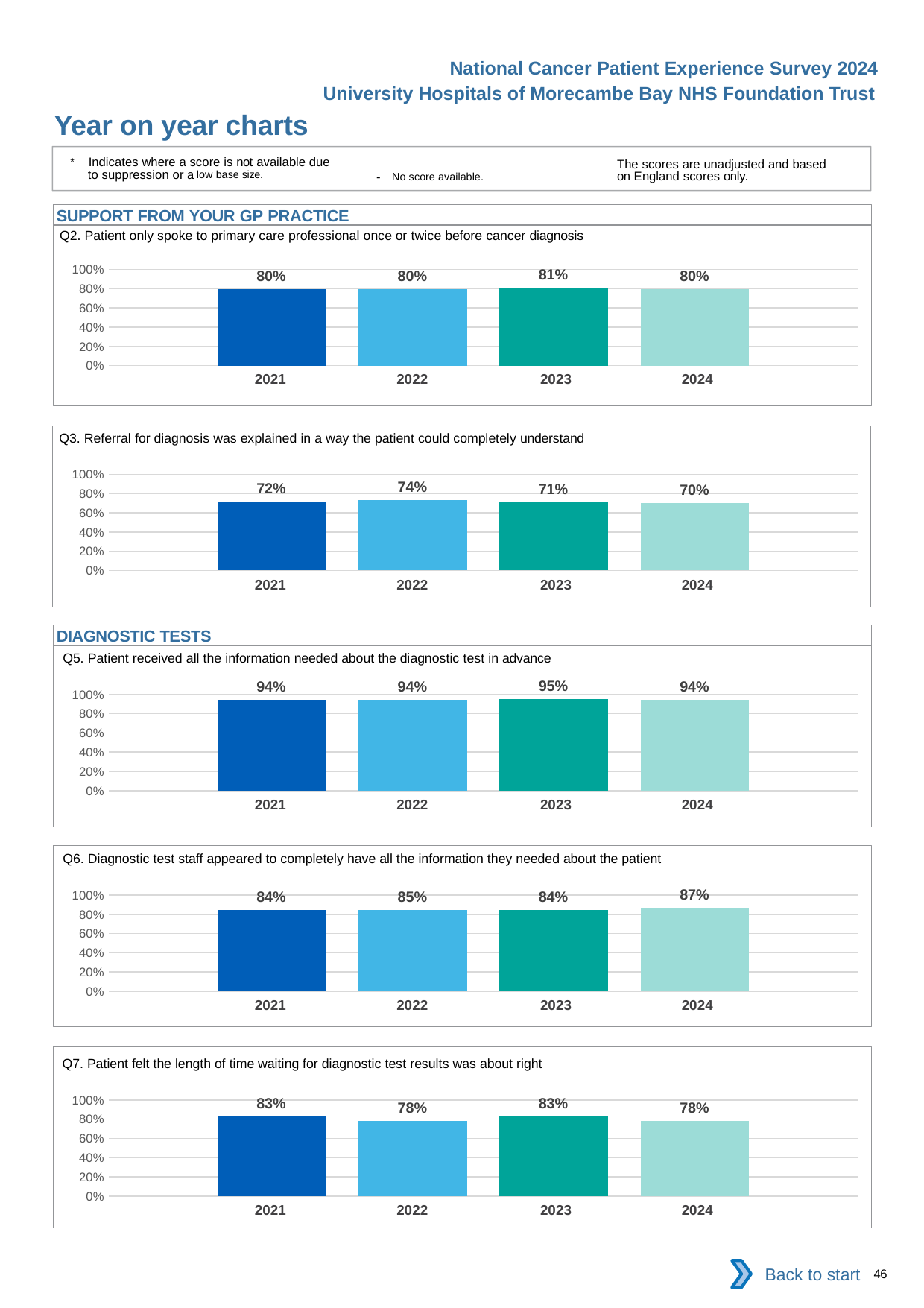
In the Q7 chart (patient felt the length of time waiting for diagnostic test results was about right), what is the value for 2022? 78% In the Q3 chart (referral for diagnosis was explained in a way the patient could completely understand), which year has the highest value? 2022 In the Q3 chart (referral for diagnosis was explained in a way the patient could completely understand), do the values rise or fall from 2022 to 2024? Fall In the Q3 chart (referral for diagnosis was explained in a way the patient could completely understand), which year has the lowest value? 2024 How many years are shown on the x axis of the Q2 chart (patient only spoke to primary care professional once or twice before cancer diagnosis)? 4 What kind of chart is the Q5 chart (patient received all the information needed about the diagnostic test in advance)? Bar chart In the Q6 chart (diagnostic test staff appeared to completely have all the information they needed about the patient), what is the difference between the 2024 and 2021 values? 3 percentage points In the Q6 chart (diagnostic test staff appeared to completely have all the information they needed about the patient), which year has the highest value? 2024 In the Q2 chart (patient only spoke to primary care professional once or twice before cancer diagnosis), what is the value for 2023? 81% In the Q3 chart (referral for diagnosis was explained in a way the patient could completely understand), what is the difference between the 2022 and 2024 values? 4 percentage points In the Q5 chart (patient received all the information needed about the diagnostic test in advance), what is the value for 2023? 95% In the Q7 chart (patient felt the length of time waiting for diagnostic test results was about right), is the value for 2021 larger or smaller than the value for 2024? larger